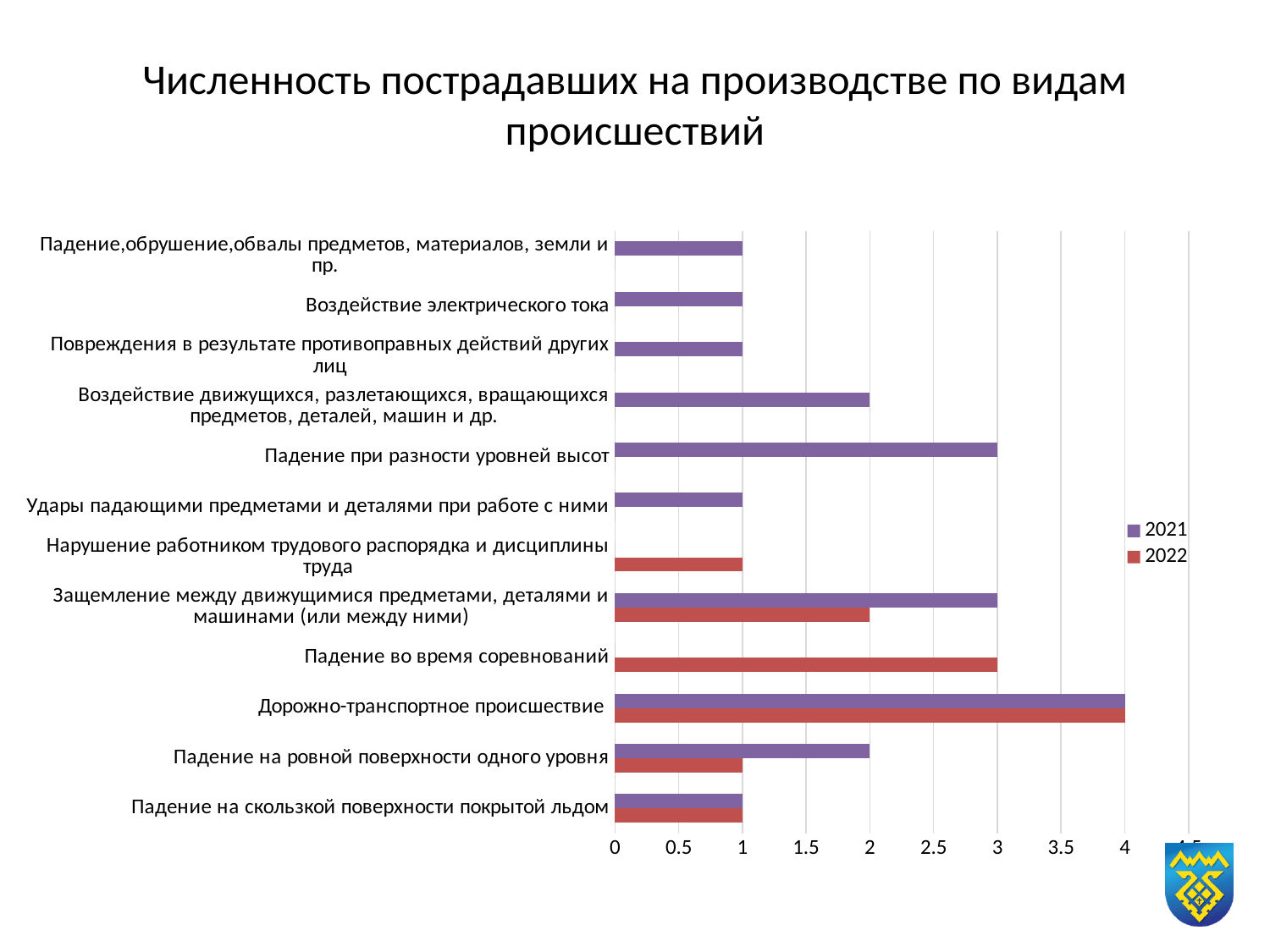
What is the 2022 value for "Защемление между движущимися предметами, деталями и машинами (или между ними)"? 2 What is the 2021 value for "Дорожно-транспортное происшествие"? 4 How many categories (types of incidents) are shown on the chart? 12 How many series does the legend list? 2 Which series is shown in purple according to the legend? 2021 What is the 2021 value for "Падение при разности уровней высот"? 3 What is the difference between the 2021 and 2022 values for "Падение на ровной поверхности одного уровня"? 1 What is the 2022 value for "Падение во время соревнований"? 3 What kind of chart is shown on the slide? Bar chart Which category has the highest 2021 value? Дорожно-транспортное происшествие What is the title of the chart? Численность пострадавших на производстве по видам происшествий Which is larger for "Защемление между движущимися предметами, деталями и машинами (или между ними)": the 2021 value or the 2022 value? 2021